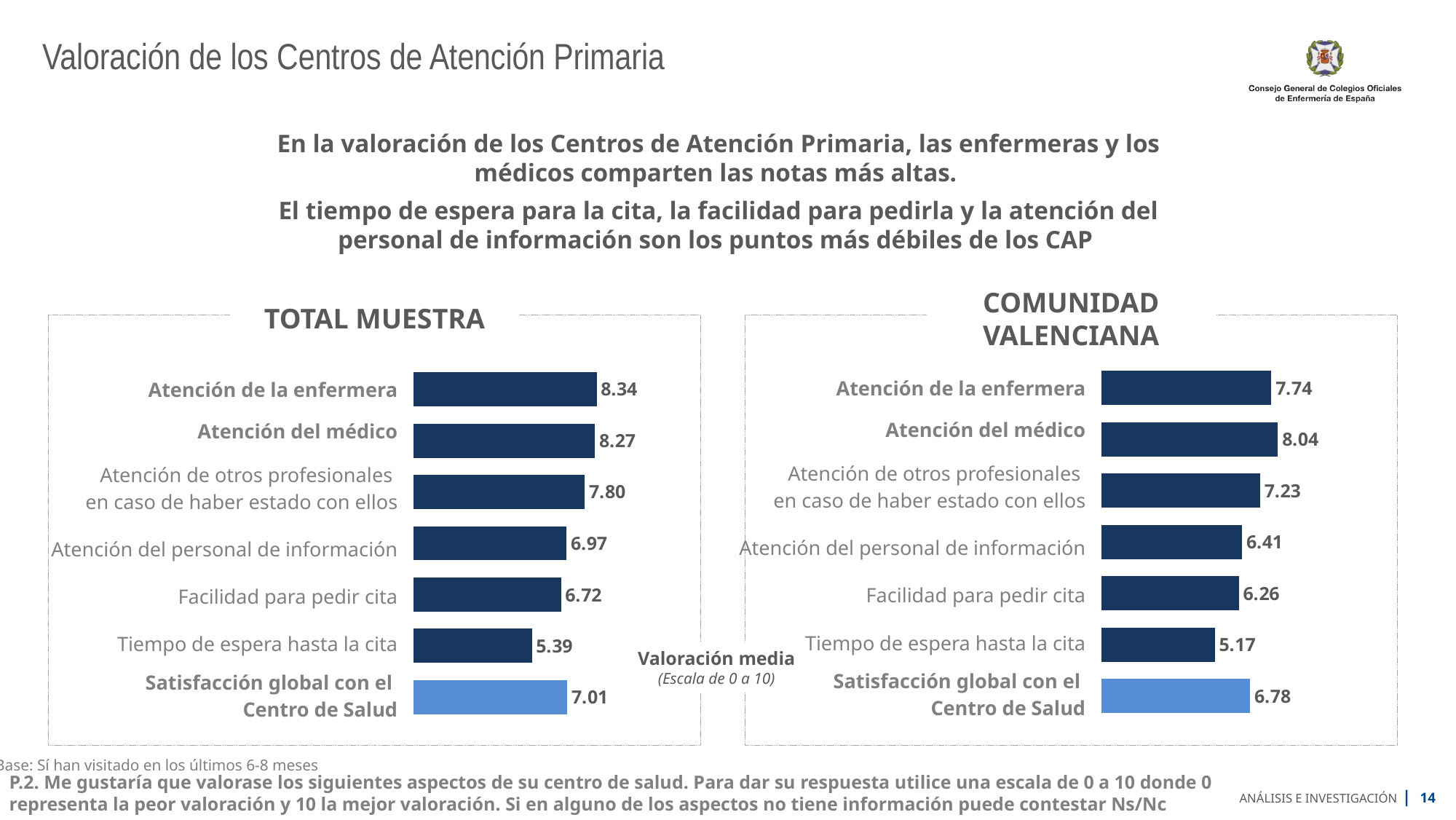
In the TOTAL MUESTRA chart, what is the value for Satisfacción global con el Centro de Salud? 7.01 In the COMUNIDAD VALENCIANA chart, which category has the highest value? Atención del médico How many categories are shown in the TOTAL MUESTRA chart? 7 In the TOTAL MUESTRA chart, which category has the highest value? Atención de la enfermera In the COMUNIDAD VALENCIANA chart, what is the value for Atención del médico? 8.04 Which is larger: Facilidad para pedir cita in the TOTAL MUESTRA chart or in the COMUNIDAD VALENCIANA chart? TOTAL MUESTRA In the TOTAL MUESTRA chart, what is the difference between Atención de la enfermera and Tiempo de espera hasta la cita? 2.95 In the COMUNIDAD VALENCIANA chart, what is the value for Tiempo de espera hasta la cita? 5.17 In the COMUNIDAD VALENCIANA chart, which category has the lowest value? Tiempo de espera hasta la cita What kind of chart is the COMUNIDAD VALENCIANA chart? Bar chart In the TOTAL MUESTRA chart, what is the value for Atención de la enfermera? 8.34 In the COMUNIDAD VALENCIANA chart, what is the difference between Atención del médico and Atención de la enfermera? 0.30